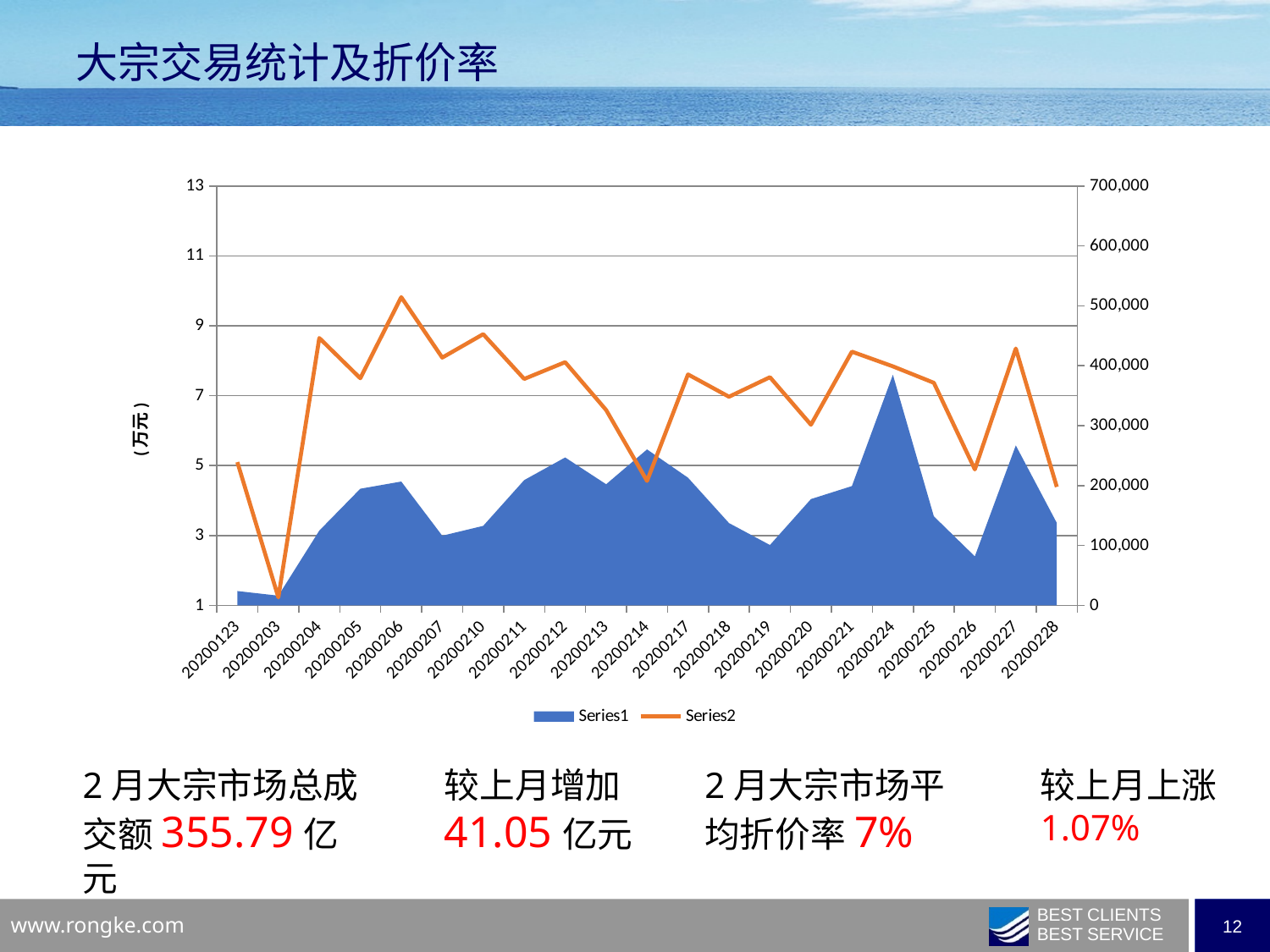
Does the Series2 line rise or fall between 20200203 and 20200206? rise How many series does the chart legend list? 2 What colour is the Series1 area in the chart? Blue At which date does the blue Series1 area reach its highest point? 20200224 What are the names of the two series in the legend? Series1 and Series2 Which is larger for Series2: the value at 20200206 or the value at 20200214? 20200206 Reading against the left axis, is the Series2 value at 20200206 greater or less than 9? greater What kind of chart is shown on the slide? A combination area and line chart How many dates are shown along the x axis of the chart? 21 Reading against the left axis, is the Series2 value at 20200203 greater or less than 3? less At which date does the orange Series2 line reach its lowest point? 20200203 At which date does the orange Series2 line reach its highest point? 20200206